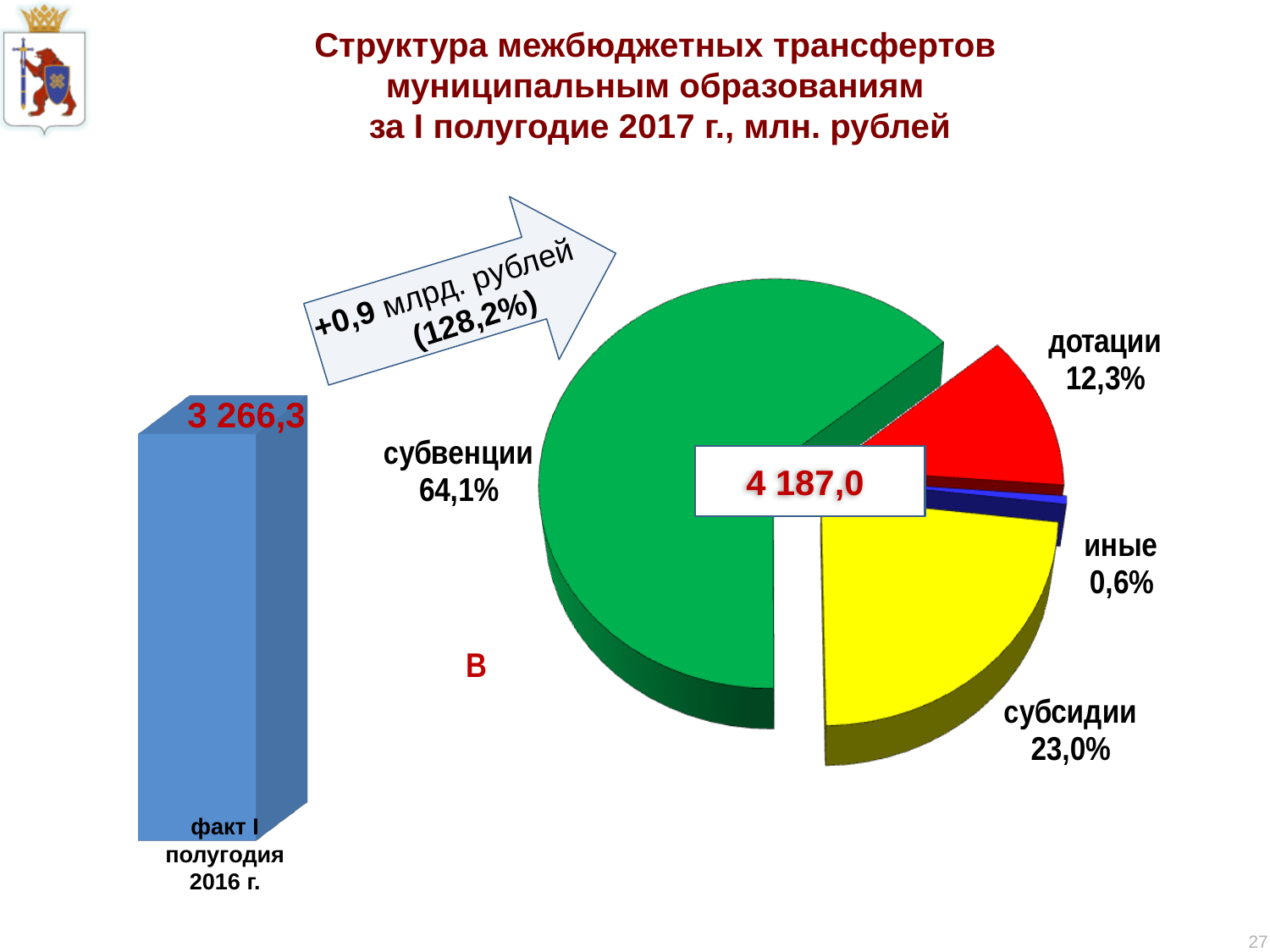
What kind of chart is shown on the left of the slide? bar chart On the pie chart, how many slices are there? 4 What value is printed in the centre of the pie chart? 4 187,0 On the pie chart, what share do дотации have? 12,3% On the pie chart, which category has the largest share? субвенции On the bar chart on the left, what is the value of the bar labelled факт I полугодия 2016 г.? 3 266,3 On the pie chart, what is the difference in percentage points between the share of субвенции and the share of субсидии? 41,1 On the pie chart, what share do субсидии have? 23,0% On the pie chart, which is larger: the share of субсидии or the share of дотации? субсидии On the pie chart, what share do субвенции have? 64,1% On the pie chart, which category has the smallest share? иные